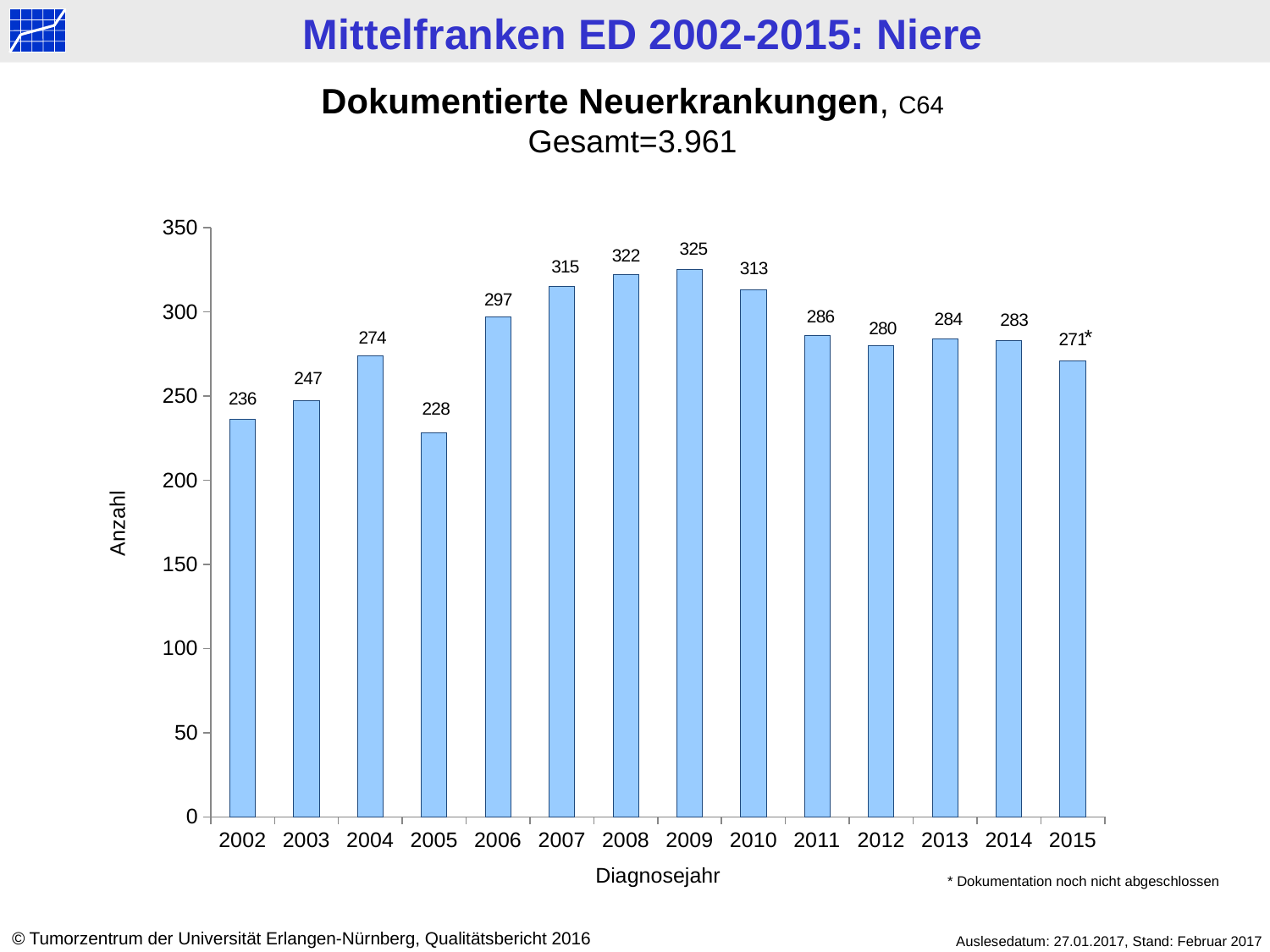
Which is larger, the value for 2004 or the value for 2014? 2014 What total (Gesamt) is stated above the chart? 3.961 Is the value for 2010 greater or less than 300? greater What is the value for 2006? 297 How many years are shown on the x axis? 14 Do the values rise or fall from 2005 to 2009? rise Which year has the highest value? 2009 What is the label of the x axis? Diagnosejahr Which year has the lowest value? 2005 What is the difference between the values for 2009 and 2005? 97 What kind of chart is shown? bar chart What is the value for 2012? 280